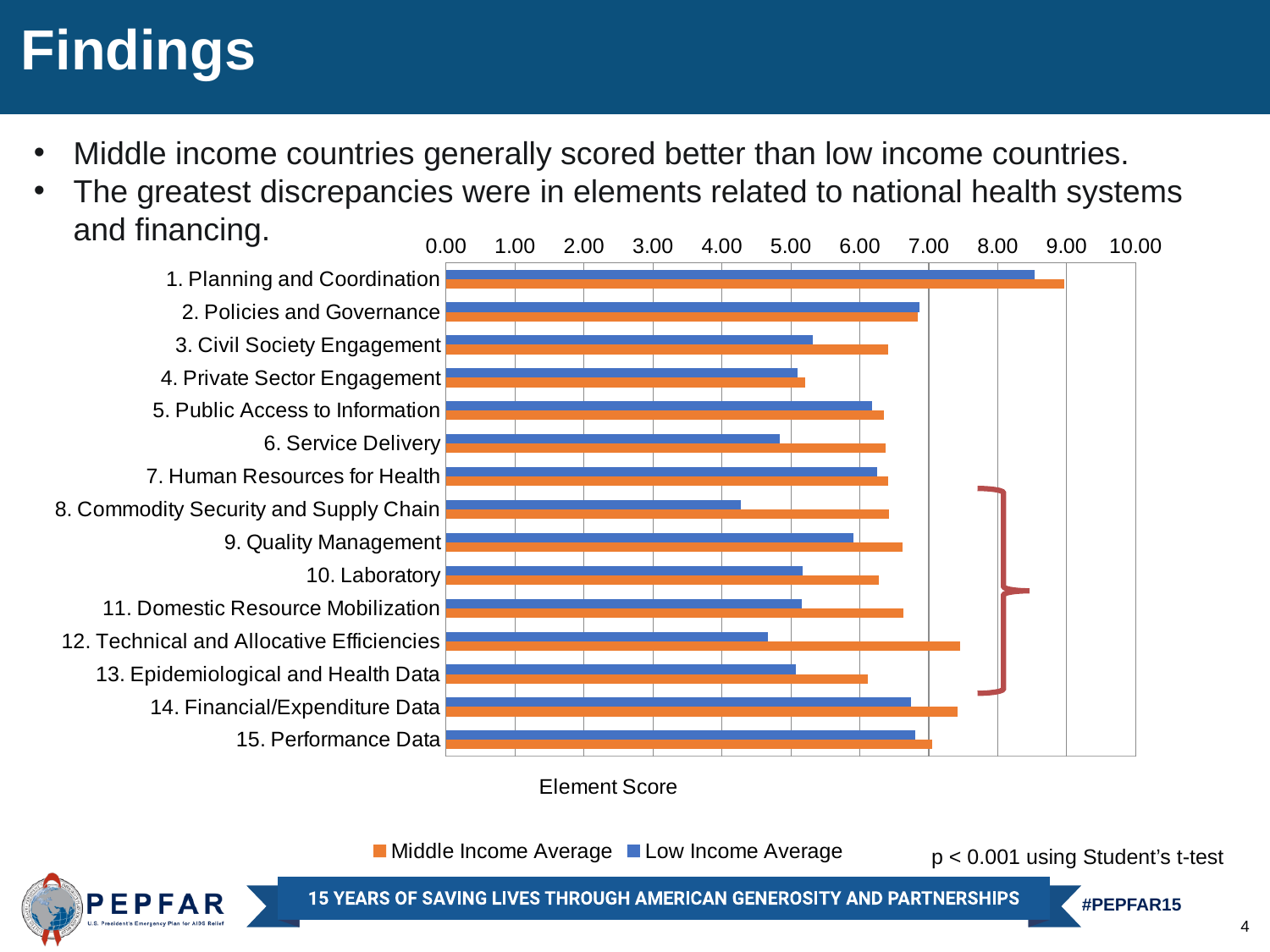
How many elements (categories) are plotted on the chart? 15 What is the title of the chart's horizontal axis? Element Score Is the Middle Income Average for 1. Planning and Coordination greater or less than 8.00? greater Which element has the lowest Middle Income Average score? 4. Private Sector Engagement For 12. Technical and Allocative Efficiencies, which is larger: the Middle Income Average or the Low Income Average? Middle Income Average What kind of chart is shown on the slide? Bar chart Which element has the lowest Low Income Average score? 8. Commodity Security and Supply Chain Is the Low Income Average for 8. Commodity Security and Supply Chain greater or less than 5.00? less How many series does the chart's legend list? 2 Which element has the highest Middle Income Average score? 1. Planning and Coordination Is the Middle Income Average for 12. Technical and Allocative Efficiencies greater or less than 7.00? greater For 8. Commodity Security and Supply Chain, which is larger: the Middle Income Average or the Low Income Average? Middle Income Average